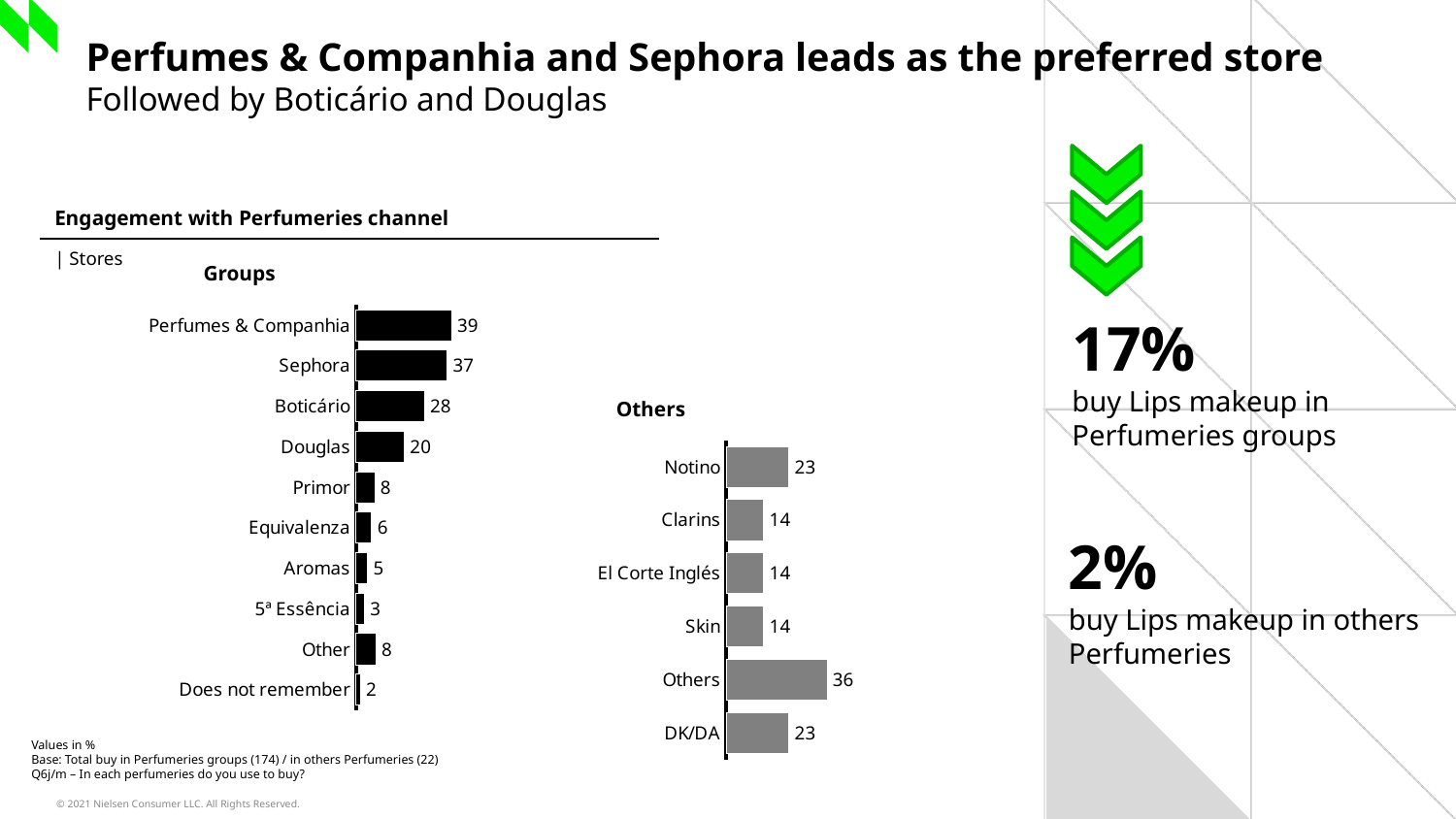
How many categories are shown in the Groups chart? 10 In the Others chart, what is the value for Notino? 23 In the Others chart, what is the difference between Others and Clarins? 22 In the Groups chart, which is larger, Boticário or Douglas? Boticário In the Groups chart, which category has the lowest value? Does not remember In the Groups chart, which store has the highest value? Perfumes & Companhia In the Groups chart, what is the value for Sephora? 37 In the Others chart, which category has the highest value? Others How many categories are shown in the Others chart? 6 What type of chart is the Others chart? Bar chart In the Groups chart, what is the value for Douglas? 20 In the Groups chart, what is the difference between Perfumes & Companhia and Boticário? 11